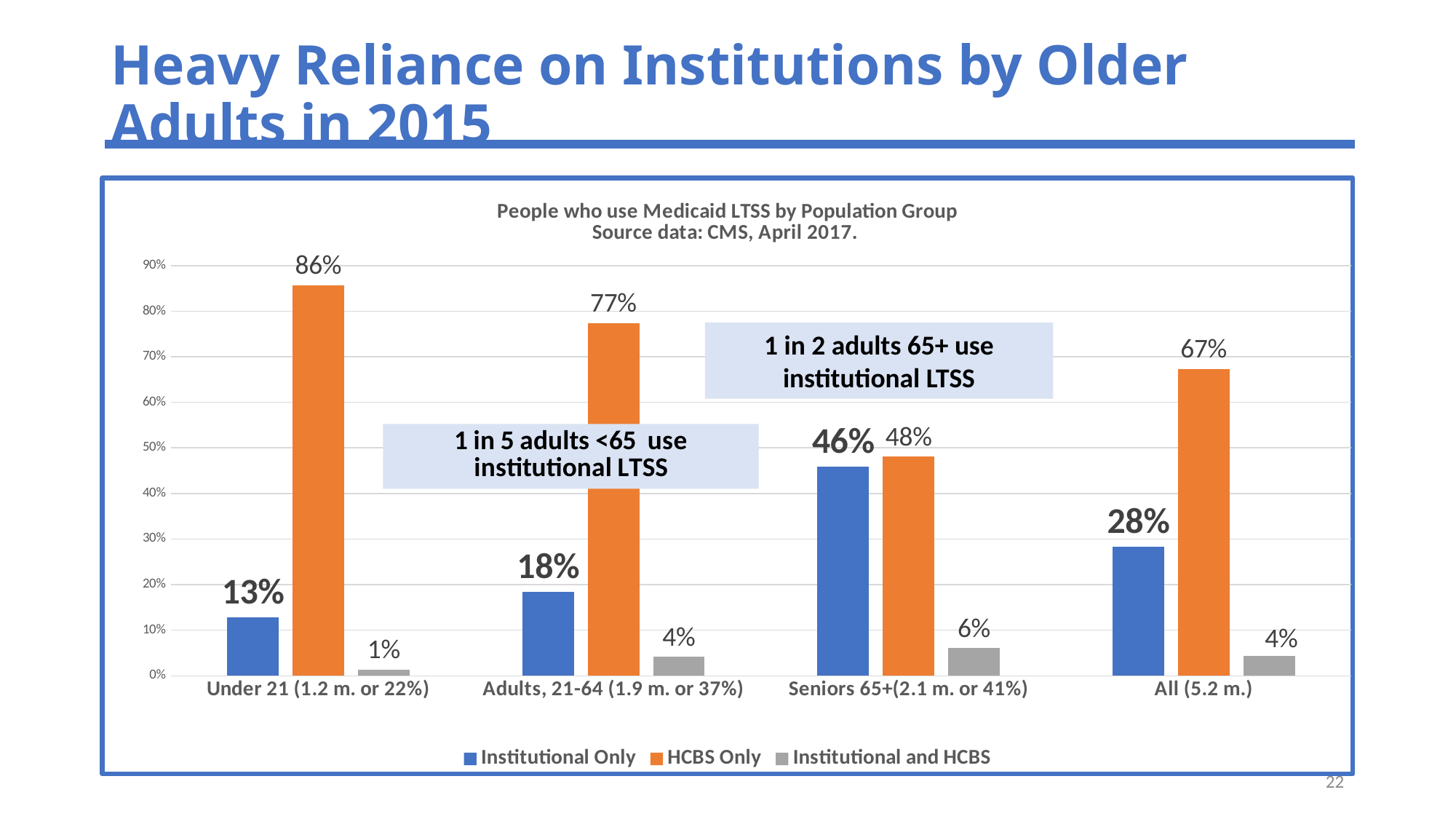
What is the HCBS Only value for Under 21? 86% Which population group has the lowest HCBS Only value? Seniors 65+ Which is larger for Seniors 65+: Institutional Only or HCBS Only? HCBS Only What kind of chart is shown on the slide? Bar chart What is the HCBS Only value for All? 67% How many population groups are shown on the x axis? 4 What is the Institutional Only value for Seniors 65+? 46% What is the Institutional and HCBS value for Adults, 21-64? 4% What is the difference between the HCBS Only values for Under 21 and Adults, 21-64? 9% Which series is shown in orange? HCBS Only Which population group has the highest Institutional Only value? Seniors 65+ How many series does the legend list? 3